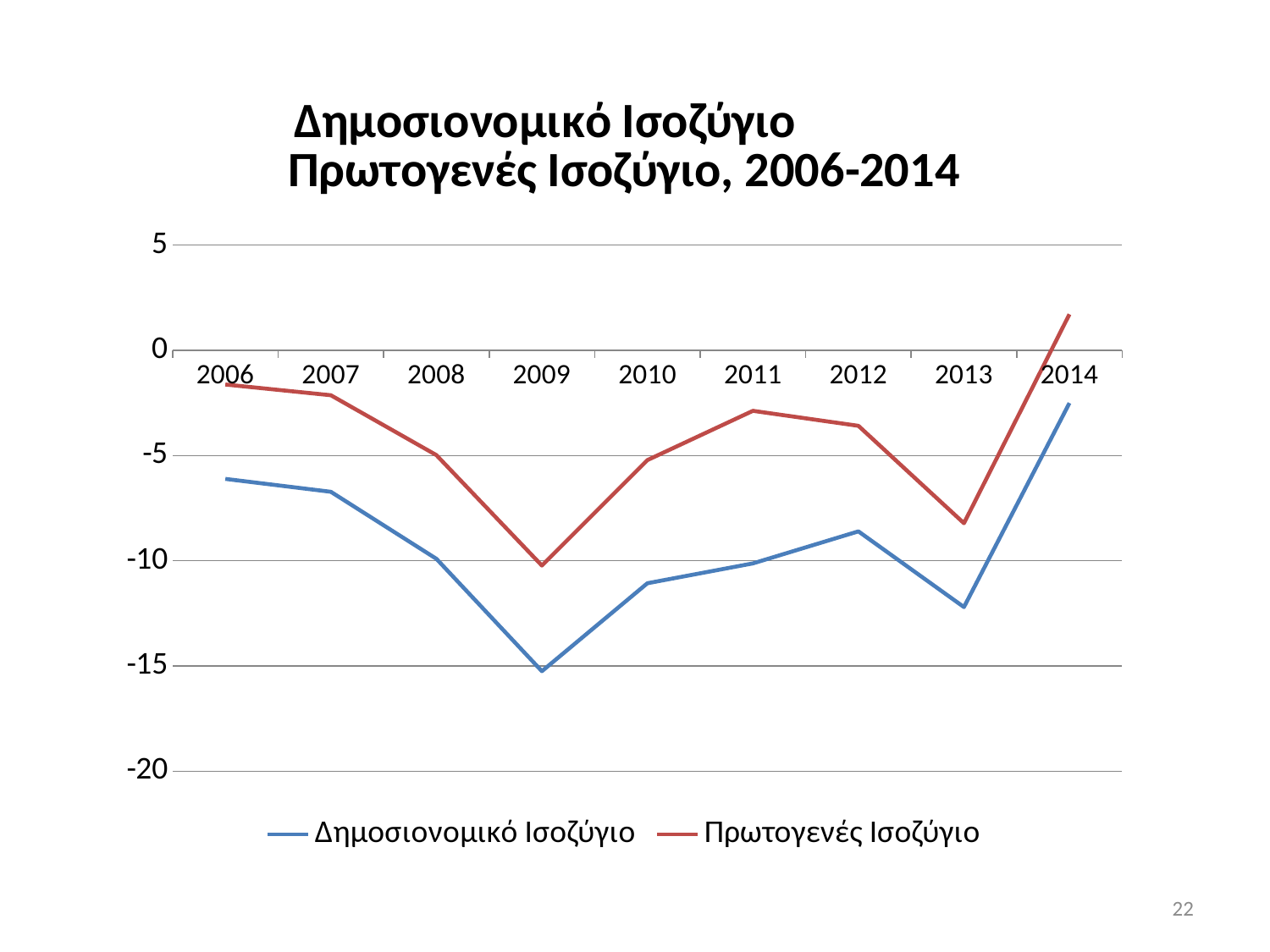
How many series does the legend list? 2 What kind of chart is shown on the slide? line chart How many years are plotted along the x axis? 9 Which colour is used for the Πρωτογενές Ισοζύγιο line? red Is the value of Δημοσιονομικό Ισοζύγιο in 2009 greater or less than -10? less Does the Δημοσιονομικό Ισοζύγιο line rise or fall from 2006 to 2009? fall In 2009, which series has the higher value, Δημοσιονομικό Ισοζύγιο or Πρωτογενές Ισοζύγιο? Πρωτογενές Ισοζύγιο In which year does the Πρωτογενές Ισοζύγιο line reach its highest value? 2014 Is the value of Δημοσιονομικό Ισοζύγιο in 2014 greater or less than 0? less Is the value of Πρωτογενές Ισοζύγιο in 2013 greater or less than -5? less In which year does the Δημοσιονομικό Ισοζύγιο line reach its lowest value? 2009